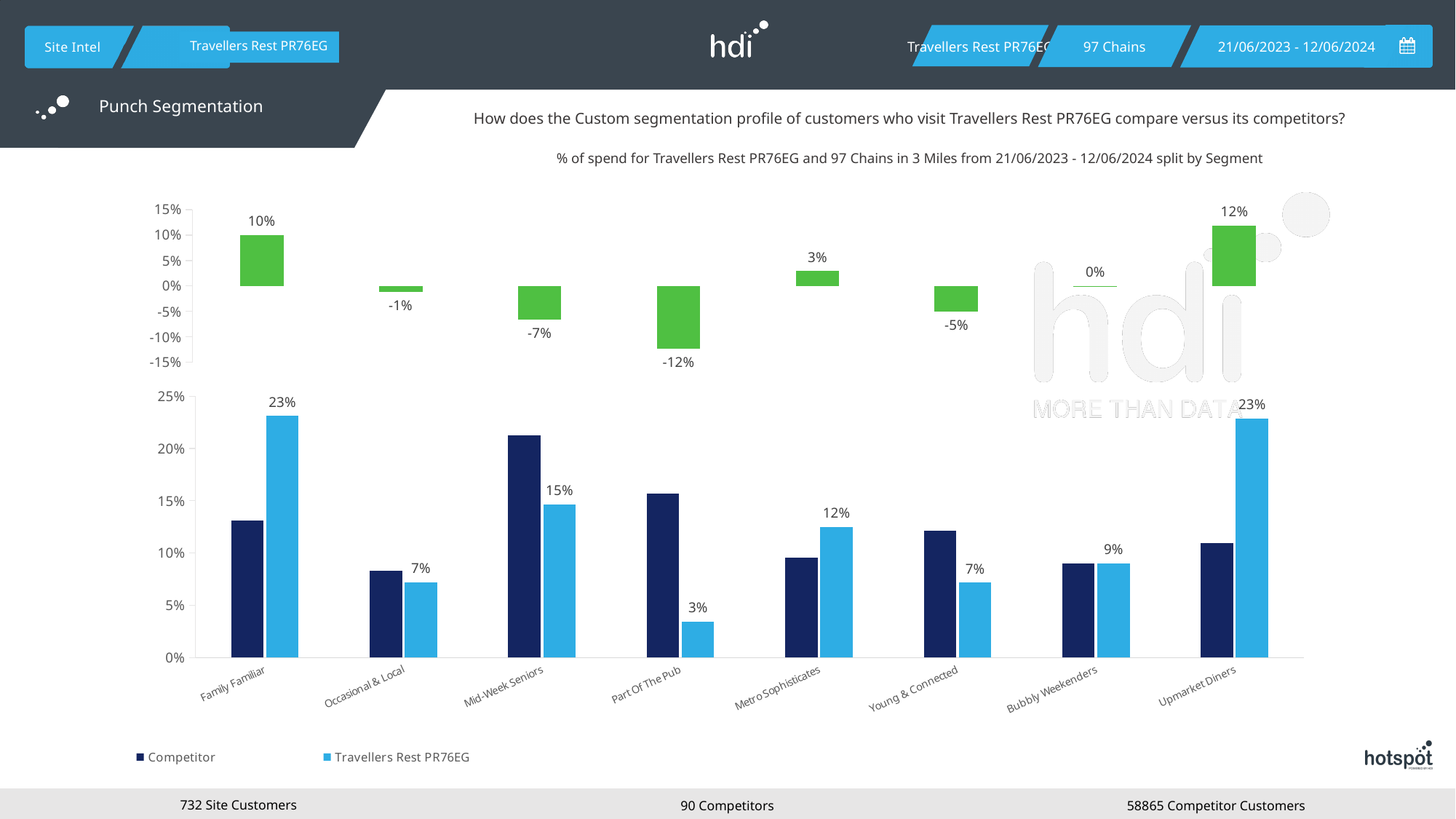
In the top chart, which segment has the lowest value? Part Of The Pub What type of chart is the bottom chart? Bar chart In the bottom chart, what is the Travellers Rest PR76EG value for Mid-Week Seniors? 15% In the top chart, what is the value for Bubbly Weekenders? 0% In the top chart, which segment has the highest value? Upmarket Diners In the bottom chart, what is the difference between the Travellers Rest PR76EG values for Family Familiar and Metro Sophisticates? 11% In the bottom chart, what is the Travellers Rest PR76EG value for Part Of The Pub? 3% In the bottom chart, which is larger for Part Of The Pub: the Competitor value or the Travellers Rest PR76EG value? Competitor How many series does the legend of the bottom chart list? 2 How many segments are shown on the x axis of the bottom chart? 8 In the top chart, what is the value for Part Of The Pub? -12% In the bottom chart, is the Competitor value for Mid-Week Seniors greater or less than 20%? greater